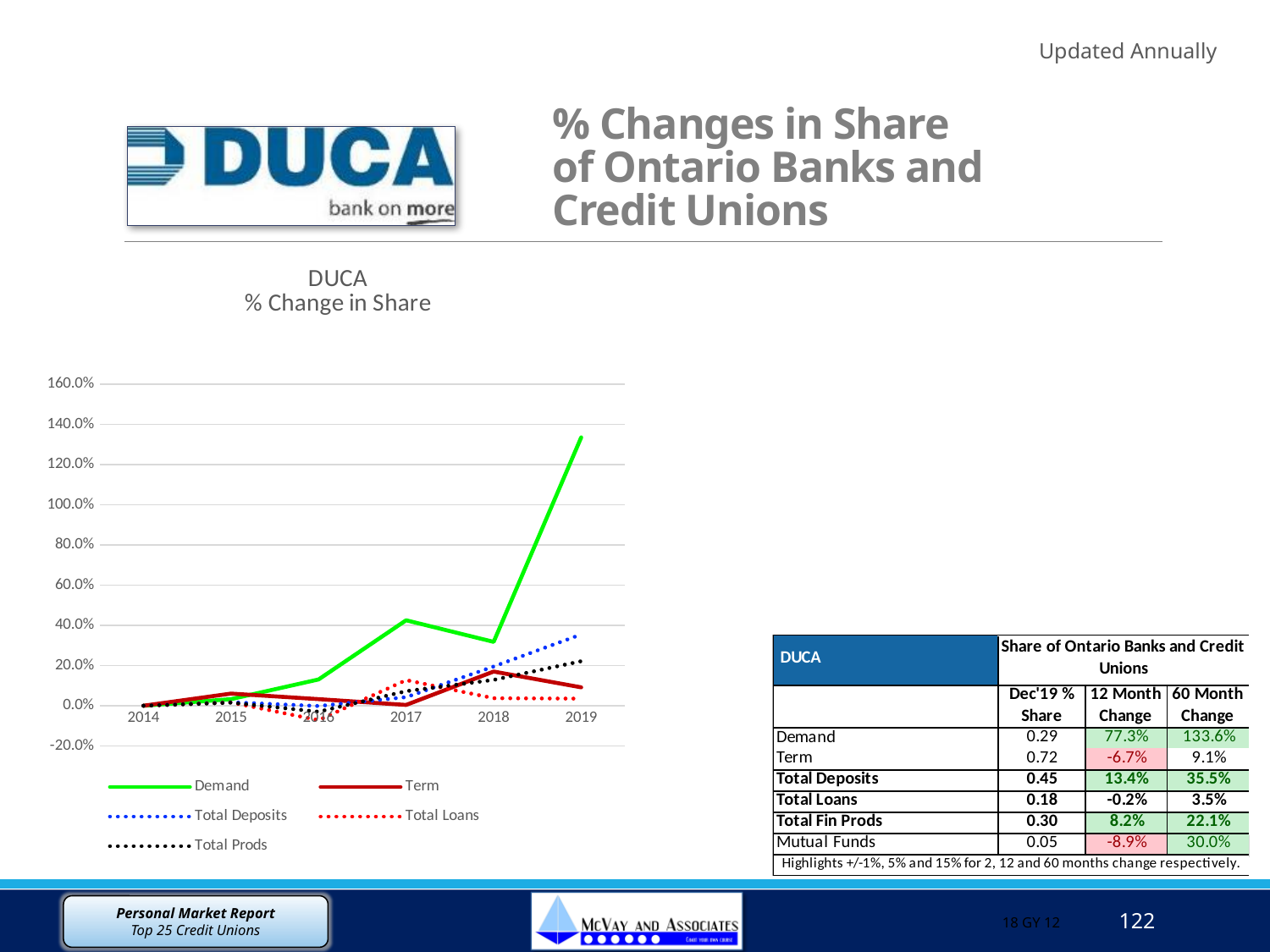
Which series has the highest value in 2019? Demand Does the Demand line rise or fall from 2018 to 2019? rise How many years are shown along the x axis of the chart? 6 Is the value for Total Deposits in 2019 greater or less than 20.0%? greater Is the value for Term in 2019 greater or less than 20.0%? less What colour is the Demand line in the chart? green Is the value for Demand in 2017 greater or less than 20.0%? greater How many series does the chart legend list? 5 Does the Term line rise or fall from 2018 to 2019? fall Which is larger in 2019, the value for Demand or the value for Term? Demand What kind of chart is shown on the slide? line chart